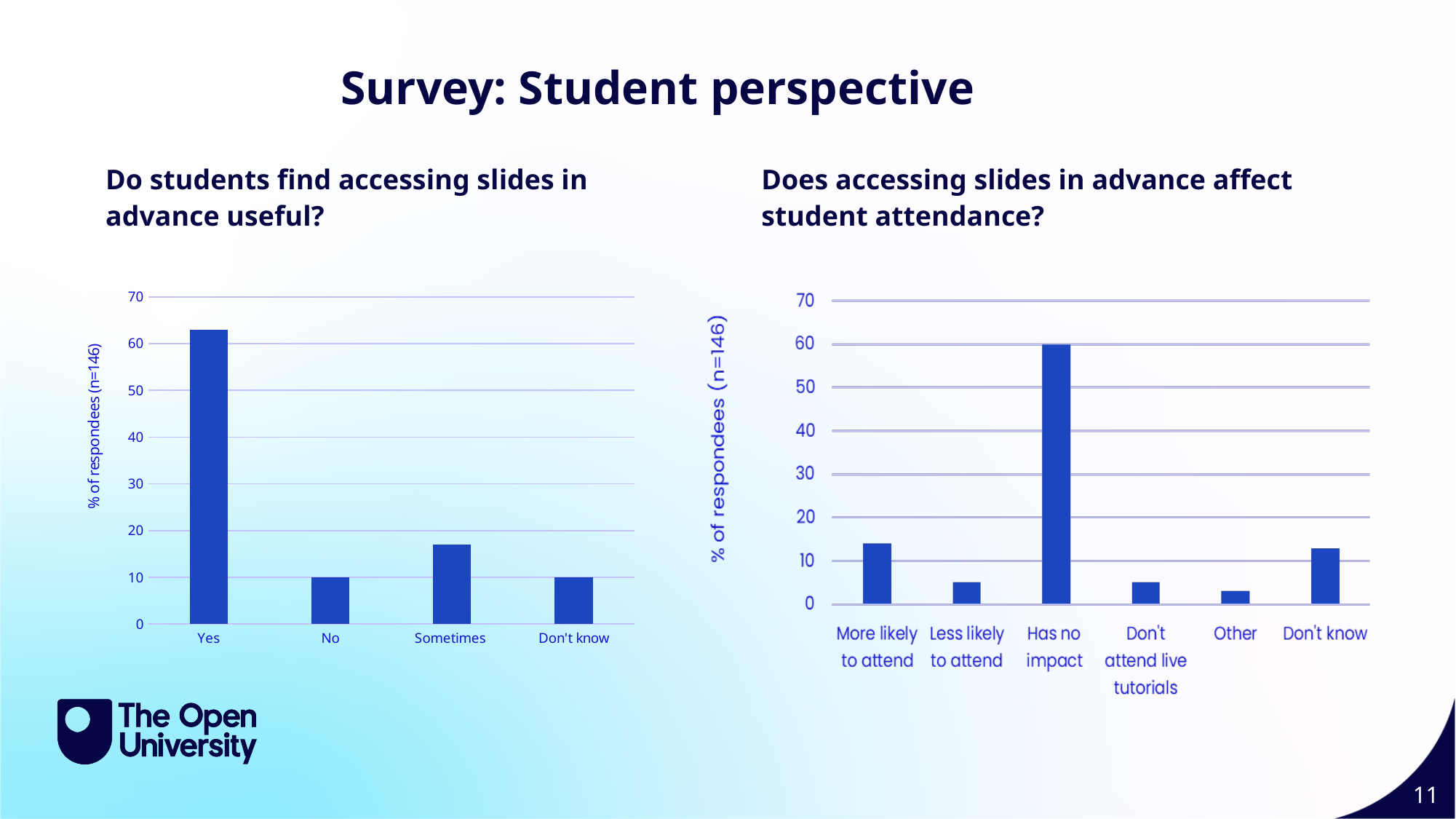
In the left chart, 'Do students find accessing slides in advance useful?', what is the value for No? 10 In the right chart, 'Does accessing slides in advance affect student attendance?', is the value for More likely to attend greater or less than 10? greater What is the y-axis label of the right chart, 'Does accessing slides in advance affect student attendance?'? % of respondees (n=146) In the right chart, 'Does accessing slides in advance affect student attendance?', how many categories are shown on the x axis? 6 In the left chart, 'Do students find accessing slides in advance useful?', which category has the highest value? Yes In the left chart, 'Do students find accessing slides in advance useful?', is the value for Sometimes greater or less than 20? less In the left chart, 'Do students find accessing slides in advance useful?', which is larger, the value for Sometimes or the value for No? Sometimes In the left chart, 'Do students find accessing slides in advance useful?', how many categories are shown on the x axis? 4 In the right chart, 'Does accessing slides in advance affect student attendance?', which category has the highest value? Has no impact In the right chart, 'Does accessing slides in advance affect student attendance?', which category has the lowest value? Other In the left chart, 'Do students find accessing slides in advance useful?', is the value for Yes greater or less than 60? greater What kind of chart is the left chart, 'Do students find accessing slides in advance useful?'? bar chart